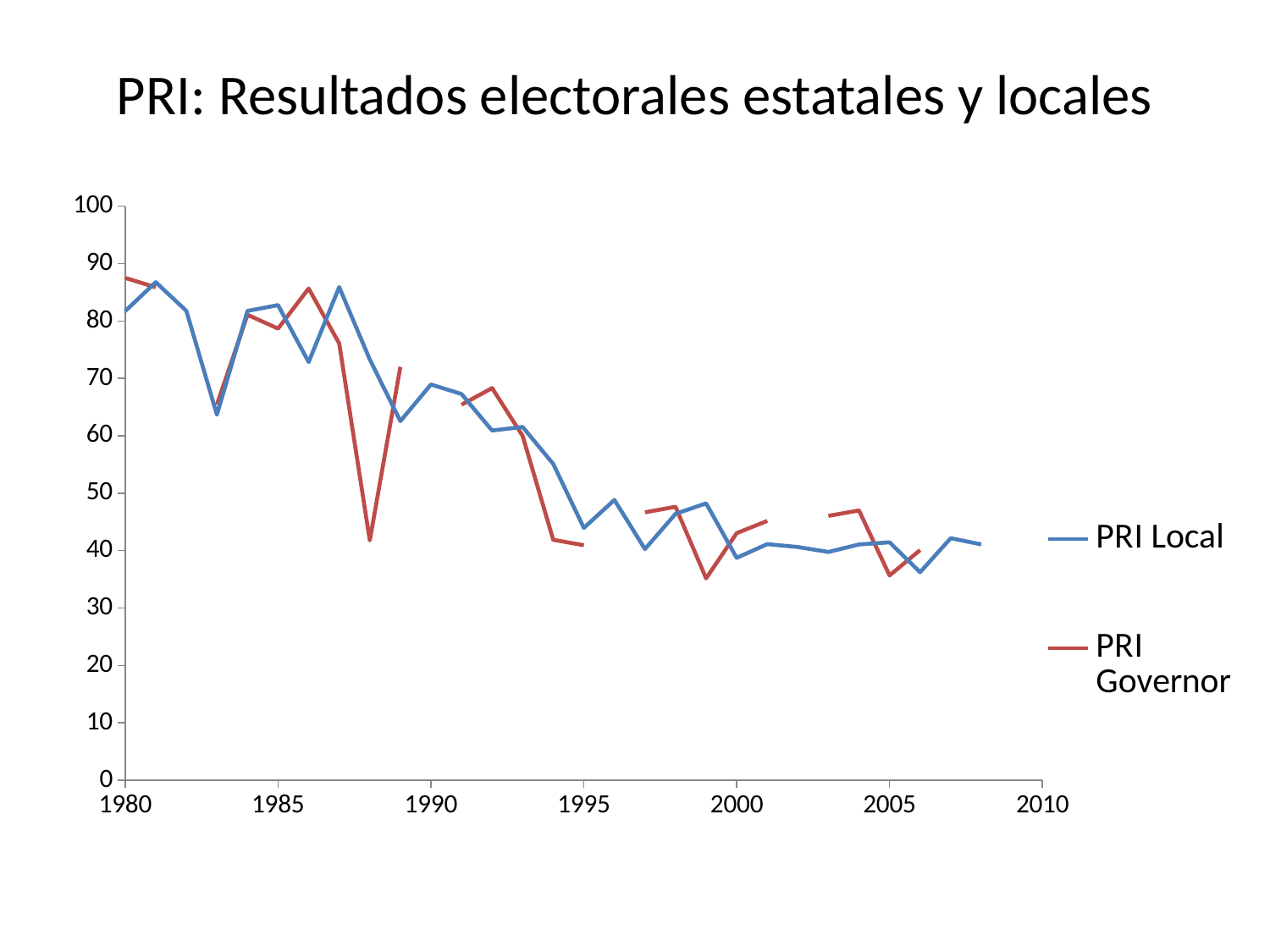
What is the title of the chart? PRI: Resultados electorales estatales y locales What kind of chart is shown on the slide? line chart Is the PRI Local value for 1983 greater or less than 70? less Overall, do the PRI Local values rise or fall from 1980 to 2008? fall In 1988, which series has the larger value, PRI Local or PRI Governor? PRI Local How many series does the legend list? 2 Is the PRI Governor value for 1988 greater or less than 50? less Is the PRI Local value for 1995 greater or less than 50? less In 1986, which series has the larger value, PRI Local or PRI Governor? PRI Governor Which series is drawn in red? PRI Governor